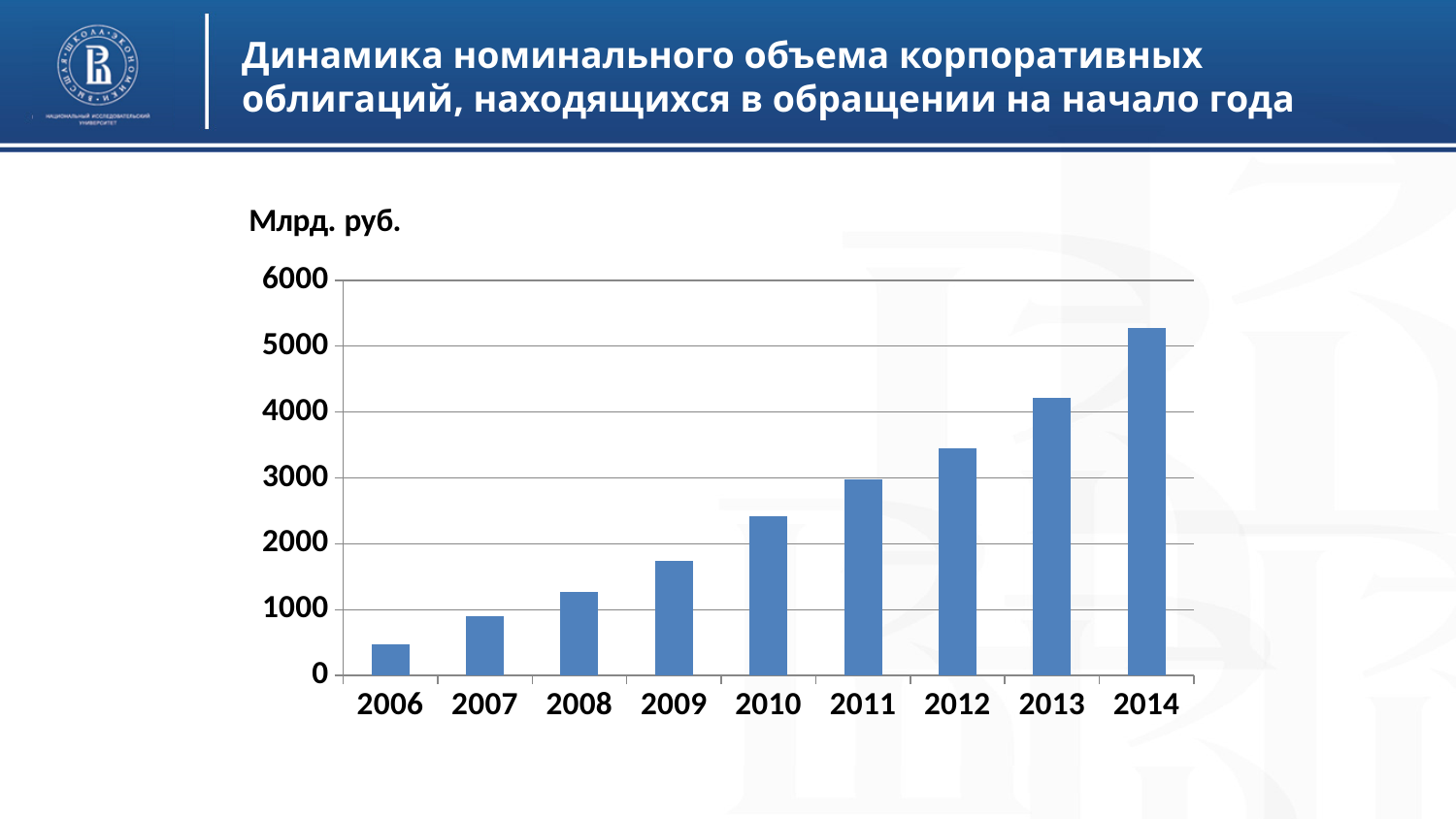
Is the value for 2013 greater or less than 4000? greater Is the value for 2007 greater or less than 1000? less What unit is shown above the y axis of the chart? Млрд. руб. What kind of chart is shown on the slide? bar chart Which year has the highest bar in the chart? 2014 Which is larger, the value for 2013 or the value for 2012? 2013 Is the value for 2010 greater or less than 2000? greater Which year has the lowest bar in the chart? 2006 How many years are shown on the x axis of the chart? 9 Do the values rise or fall from 2006 to 2014? rise